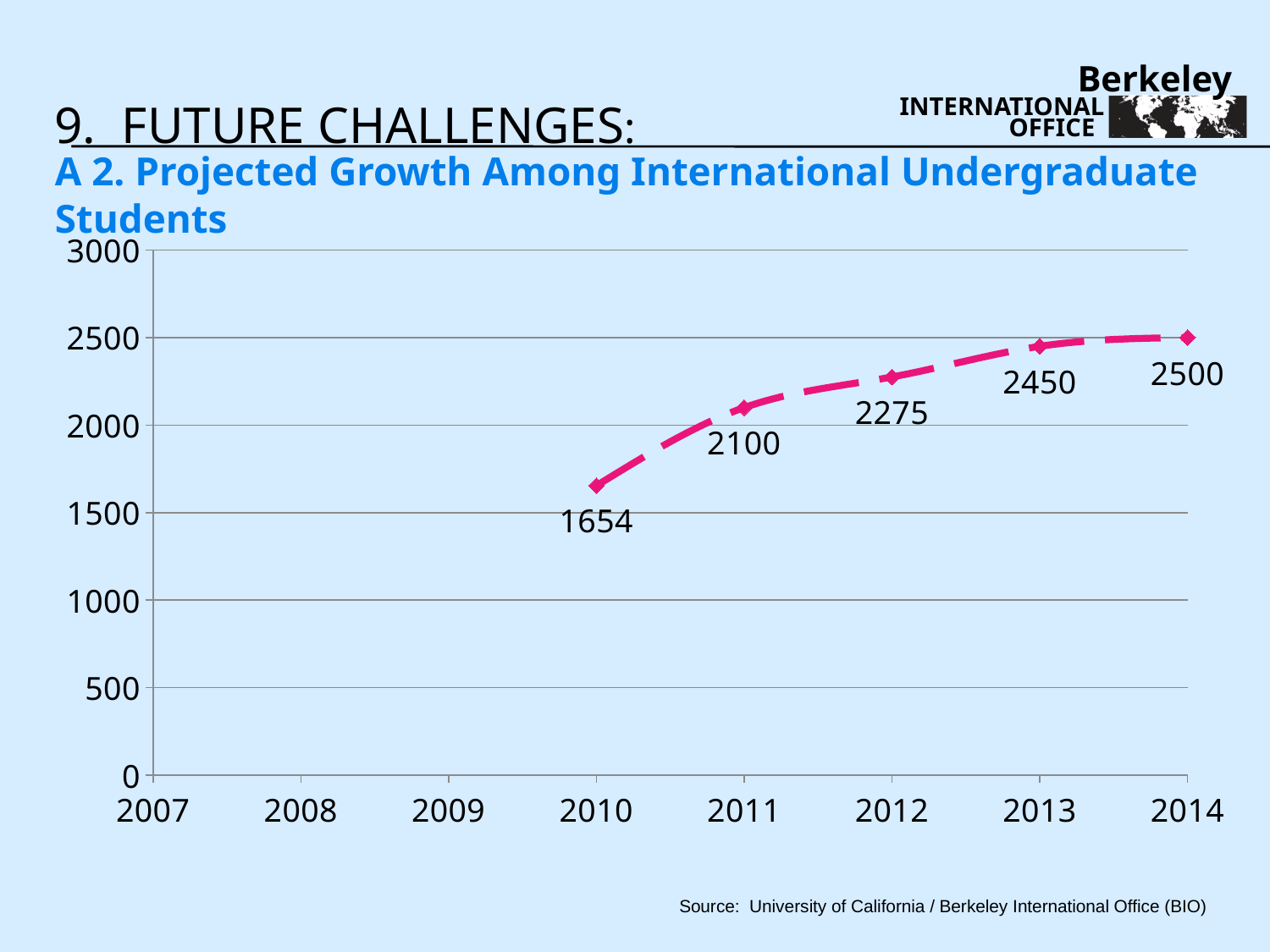
What is the projected number of international undergraduate students for 2010? 1654 What kind of chart is shown on the slide? Line chart How many data points are plotted on the line? 5 What is the projected number of international undergraduate students for 2012? 2275 What is the difference between the values for 2011 and 2010? 446 Which is larger, the value for 2012 or the value for 2013? 2013 What is the projected number of international undergraduate students for 2014? 2500 What is the difference between the values for 2014 and 2013? 50 Do the plotted values rise or fall from 2010 to 2014? Rise Is the value for 2011 greater or less than 2000? greater Which year has the lowest plotted value on the chart? 2010 Which year has the highest projected value on the chart? 2014